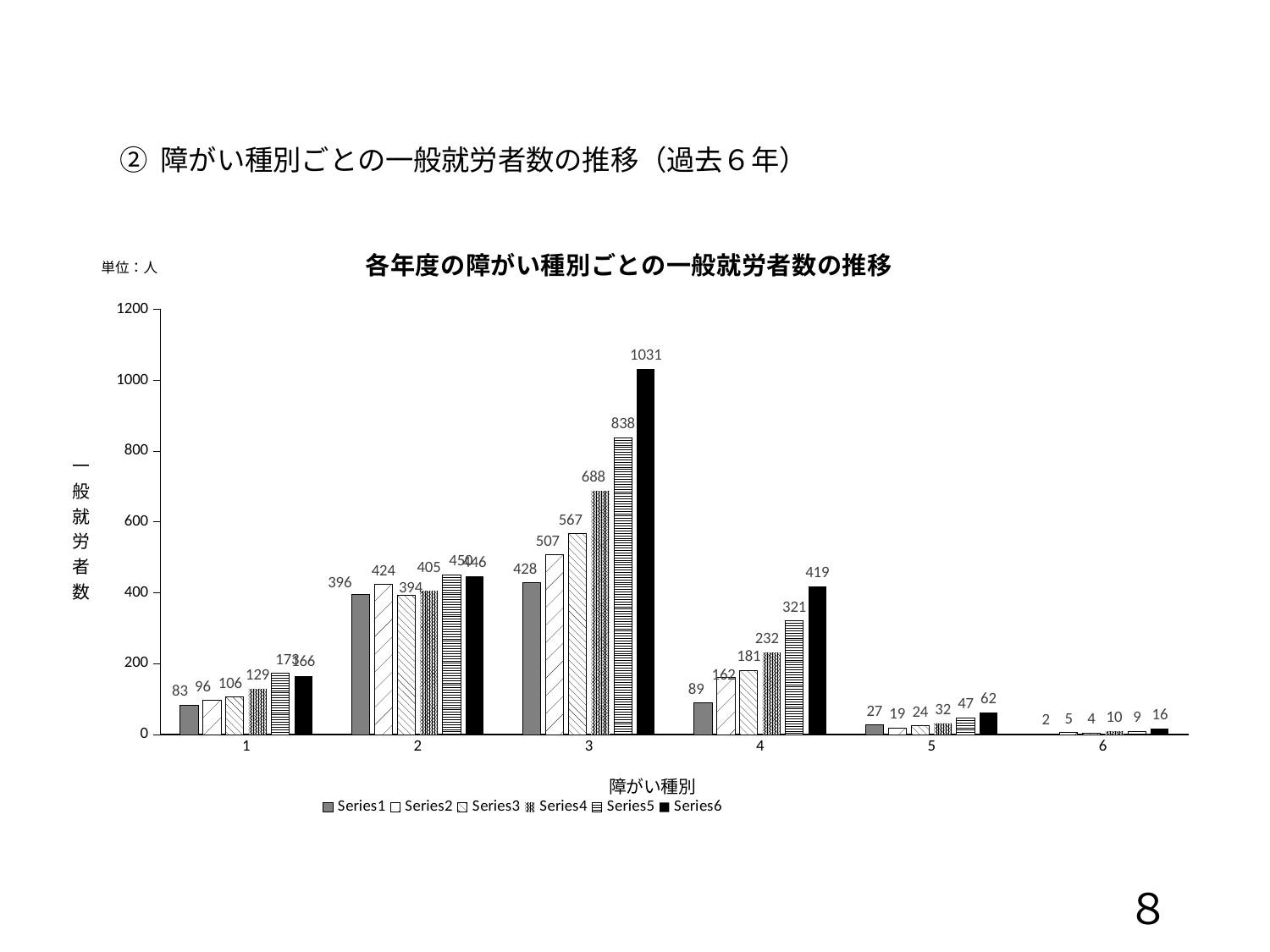
Which series has the lowest value for category 6? Series1 Which series has the highest value for category 3? Series6 How many series does the legend list? 6 What is the value of Series1 for category 5? 27 What is the value of Series6 for category 3? 1031 Is the value of Series6 for category 2 greater or less than 400? greater For category 5, which is larger: Series2 or Series3? Series3 What is the difference between Series6 and Series1 for category 3? 603 What is the value of Series5 for category 4? 321 What kind of chart is shown on the slide? bar chart How many categories are shown on the x axis? 6 For category 3, do the values rise or fall from Series1 to Series6? rise